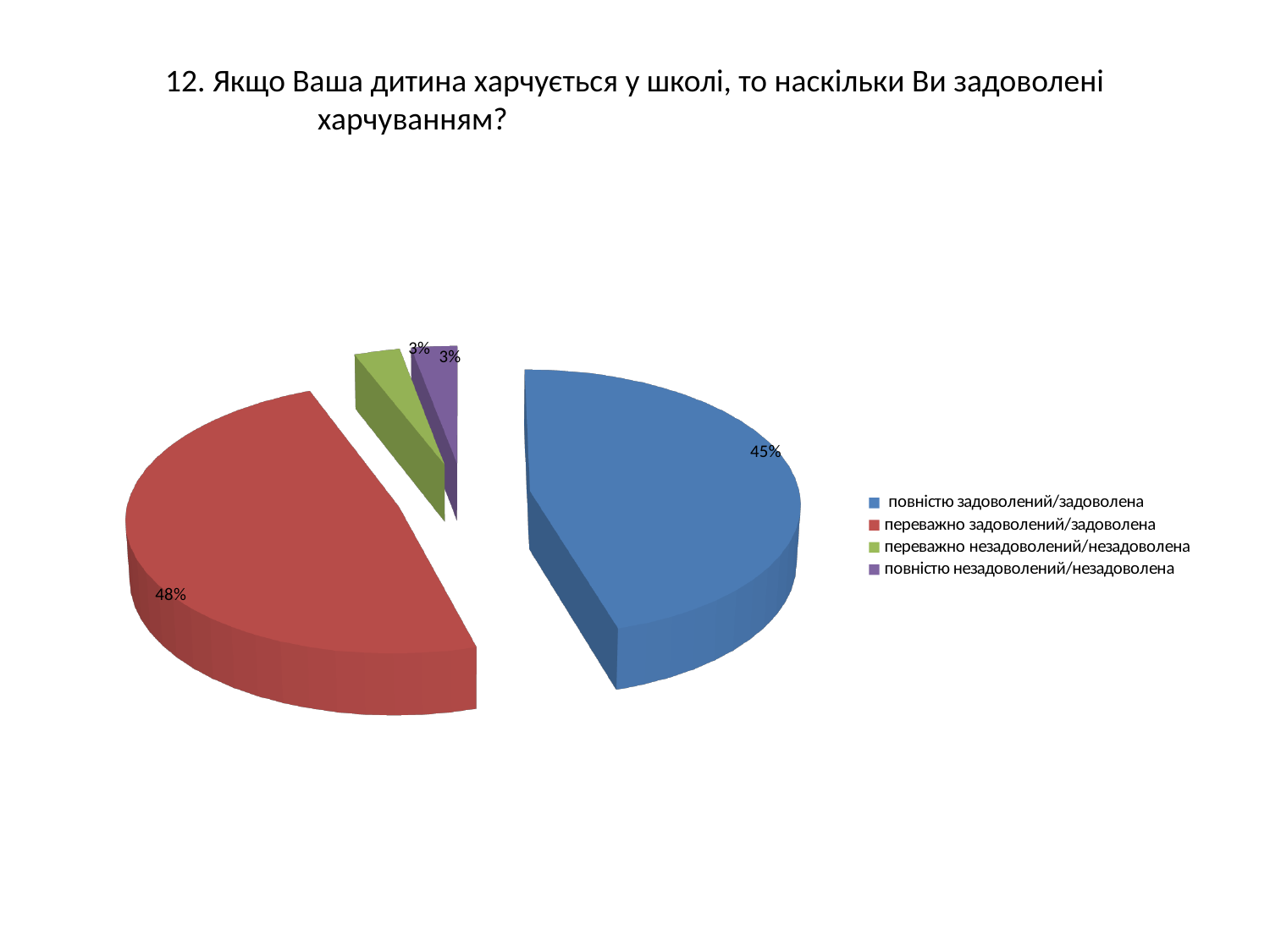
Which category has the largest slice of the pie? переважно задоволений/задоволена What is the combined share of the two "незадоволений/незадоволена" categories? 6% What share of the pie does "повністю незадоволений/незадоволена" have? 3% How many categories does the pie chart have? 4 What is the difference between the shares of "переважно задоволений/задоволена" and "повністю задоволений/задоволена"? 3% Which is larger: the slice for "повністю задоволений/задоволена" or the slice for "переважно задоволений/задоволена"? переважно задоволений/задоволена What share of the pie does "повністю задоволений/задоволена" have? 45% What colour is the slice for "повністю задоволений/задоволена"? blue What kind of chart is shown on the slide? pie chart How many entries does the legend list? 4 What share of the pie does "переважно задоволений/задоволена" have? 48% What share of the pie does "переважно незадоволений/незадоволена" have? 3%